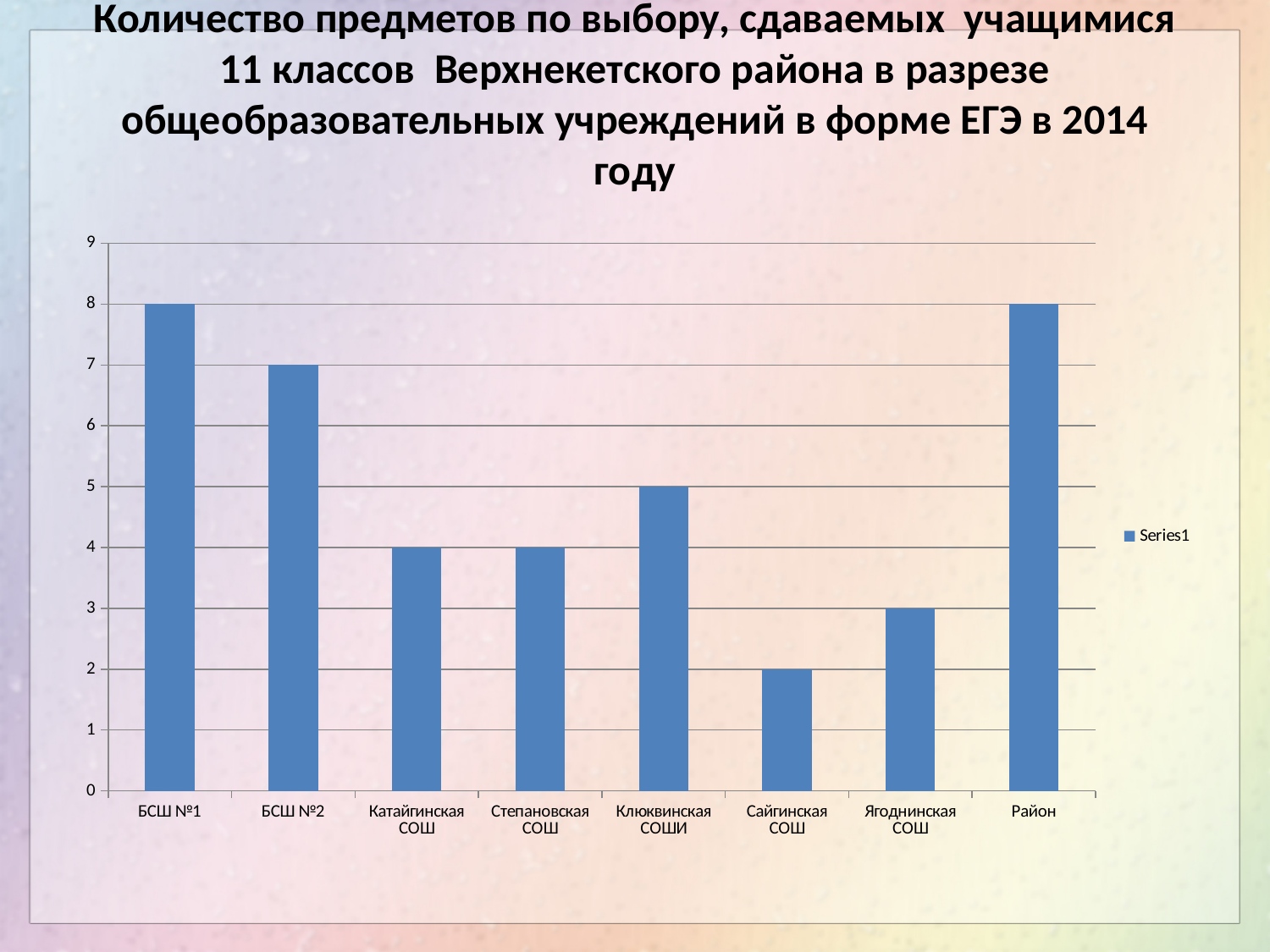
What is the value for Клюквинская СОШИ? 5 What is the name of the series shown in the legend? Series1 Which is larger, the value for Клюквинская СОШИ or the value for Степановская СОШ? Клюквинская СОШИ How many series does the legend list? 1 What kind of chart is shown on the slide? bar chart What is the value for БСШ №2? 7 How many categories are shown on the x axis of the chart? 8 What is the value for Район? 8 Is the value for Катайгинская СОШ greater or less than 6? less Which category has the lowest value? Сайгинская СОШ What is the difference between the values for БСШ №1 and Ягоднинская СОШ? 5 What is the value for Сайгинская СОШ? 2